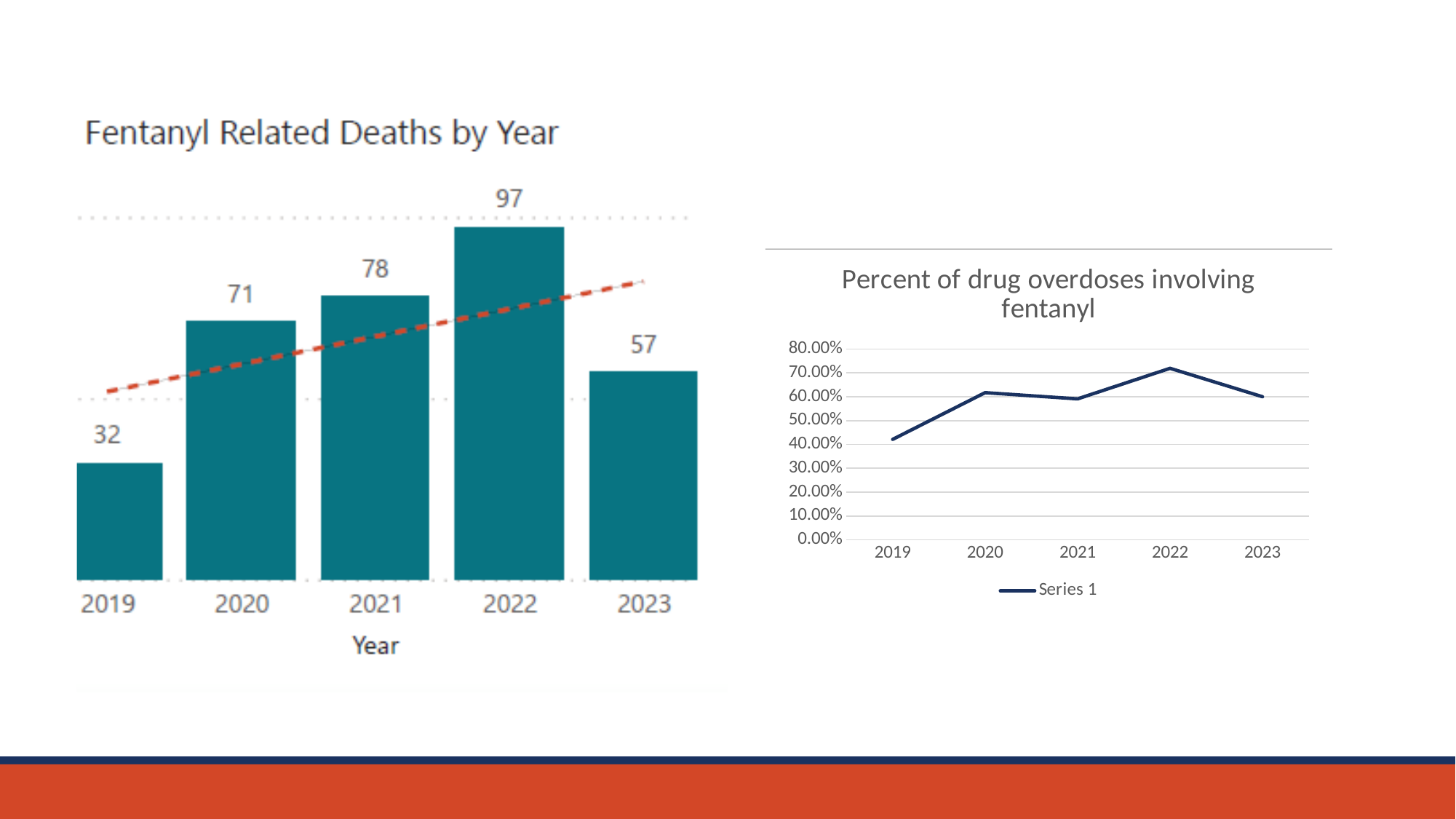
In the 'Fentanyl Related Deaths by Year' chart, which is larger, the value for 2020 or the value for 2021? 2021 In the 'Fentanyl Related Deaths by Year' chart, what is the value for 2022? 97 How many series does the legend of the 'Percent of drug overdoses involving fentanyl' chart list? 1 In the 'Percent of drug overdoses involving fentanyl' chart, which year has the highest value? 2022 What kind of chart is 'Percent of drug overdoses involving fentanyl'? Line chart How many bars are in the 'Fentanyl Related Deaths by Year' chart? 5 In the 'Fentanyl Related Deaths by Year' chart, what is the difference between the values for 2022 and 2023? 40 What kind of chart is 'Fentanyl Related Deaths by Year'? Bar chart In the 'Fentanyl Related Deaths by Year' chart, which year has the highest value? 2022 In the 'Fentanyl Related Deaths by Year' chart, what is the value for 2019? 32 In the 'Fentanyl Related Deaths by Year' chart, which year has the lowest value? 2019 In the 'Percent of drug overdoses involving fentanyl' chart, is the value for 2019 greater or less than 50.00%? less